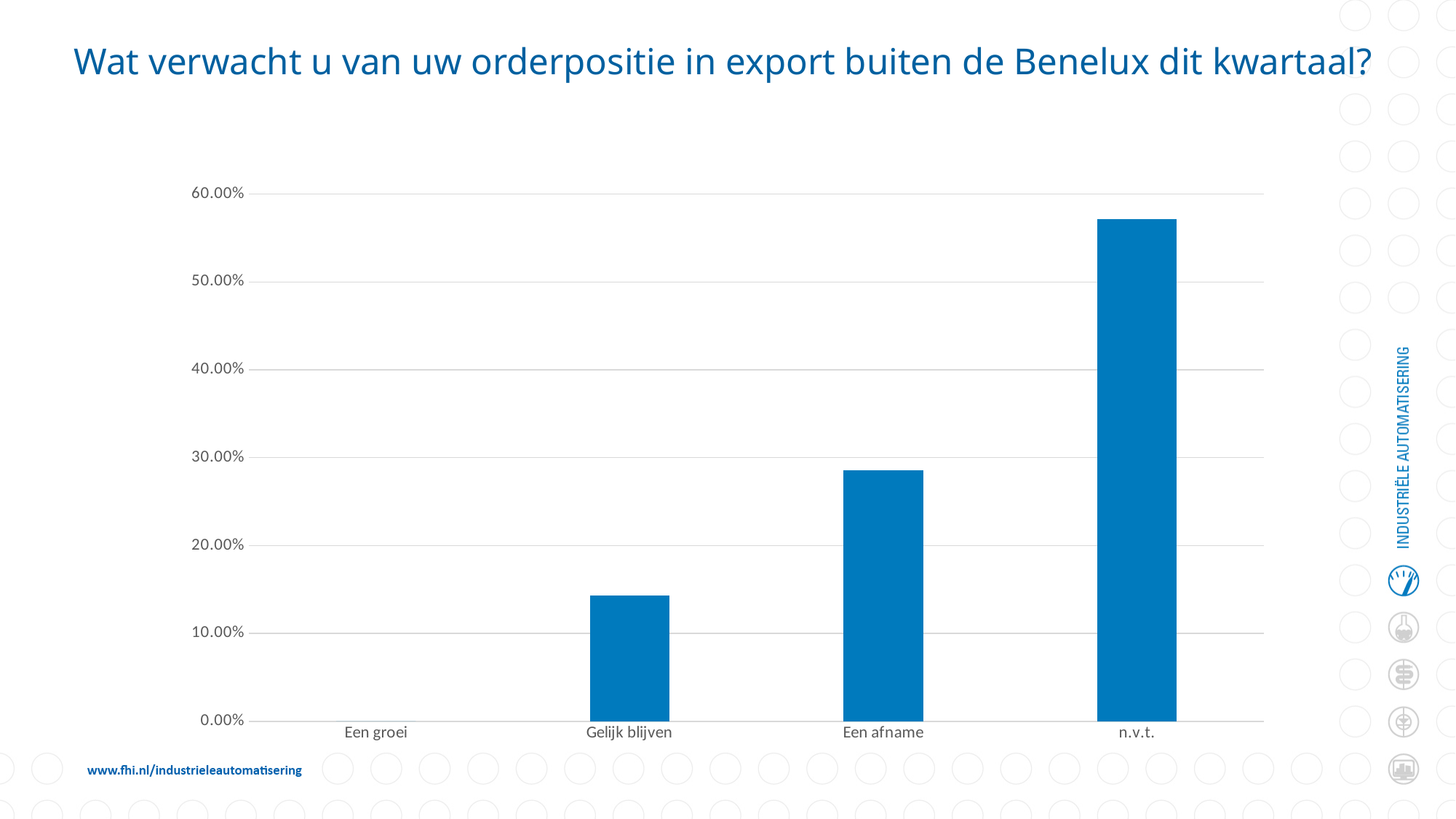
Do the bar values rise or fall from left to right along the x axis? rise What kind of chart is shown on the slide? bar chart Which category has the highest value in the chart? n.v.t. What is the value for Een groei? 0.00% What is the title of the chart on the slide? Wat verwacht u van uw orderpositie in export buiten de Benelux dit kwartaal? Is the value for Gelijk blijven greater or less than 20.00%? less Is the value for n.v.t. greater or less than 50.00%? greater Which is larger, the value for Een afname or the value for Gelijk blijven? Een afname How many categories are shown on the x axis of the chart? 4 Is the value for Gelijk blijven greater or less than 10.00%? greater Which category has the lowest value in the chart? Een groei